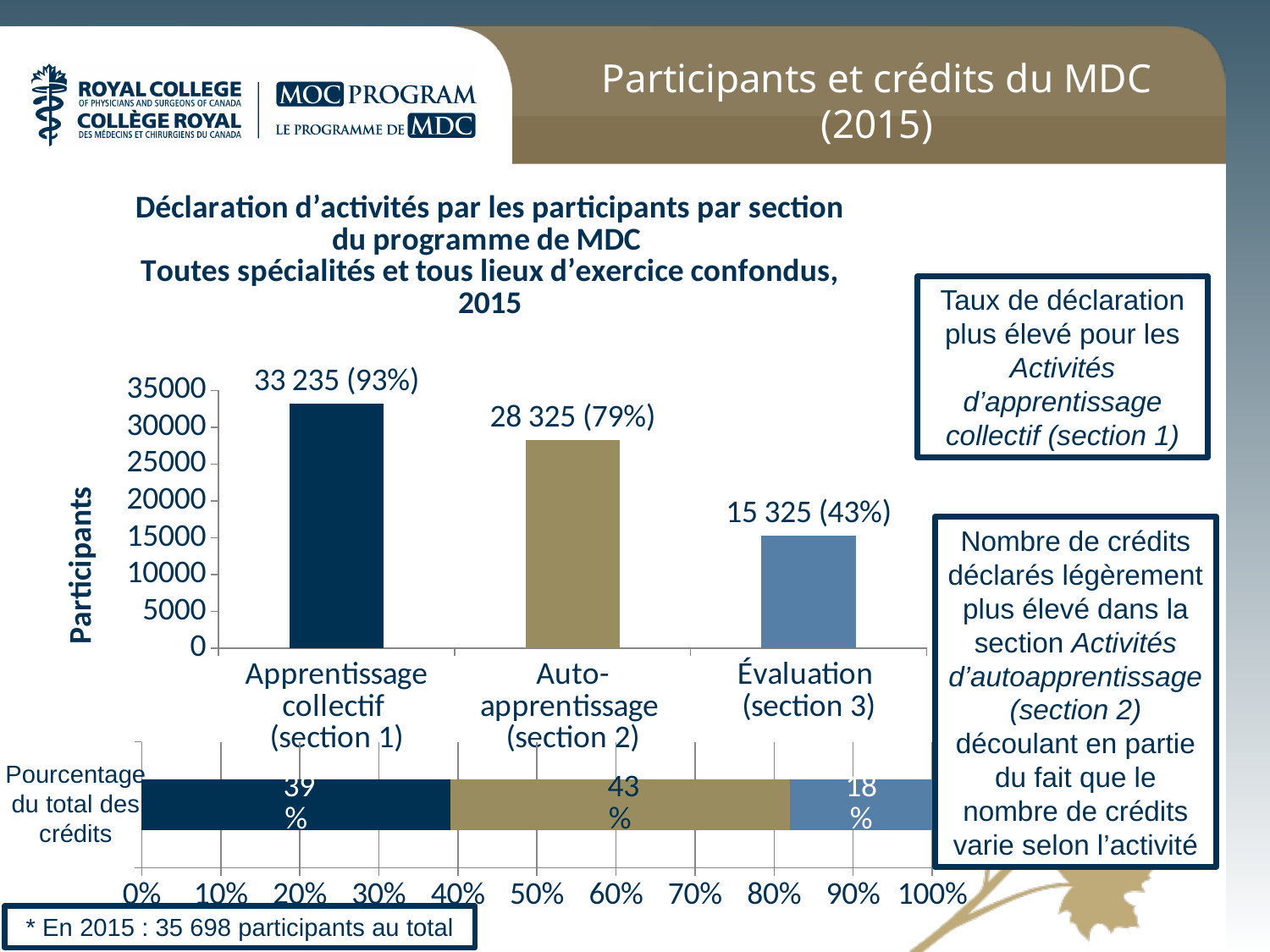
In the top bar chart, how many participants are shown for Apprentissage collectif (section 1)? 33 235 In the top bar chart, which section has the lowest number of participants? Évaluation (section 3) In the bottom stacked bar chart (Pourcentage du total des crédits), what share of total credits is attributed to Auto-apprentissage (section 2)? 43% In the top bar chart, how many participants are shown for Évaluation (section 3)? 15 325 In the top bar chart, do the participant values rise or fall from left to right across the sections? Fall What type of chart is the top chart showing participants by section? Bar chart In the bottom stacked bar chart (Pourcentage du total des crédits), what is the total of the three segments? 100% In the top bar chart, what is the difference in participants between Apprentissage collectif (section 1) and Auto-apprentissage (section 2)? 4 910 In the top bar chart, which section has the highest number of participants? Apprentissage collectif (section 1) In the bottom stacked bar chart (Pourcentage du total des crédits), which section has the smallest share of total credits? Évaluation (section 3) In the top bar chart, how many categories are plotted? 3 In the top bar chart, what percentage is shown next to the Auto-apprentissage (section 2) bar? 79%